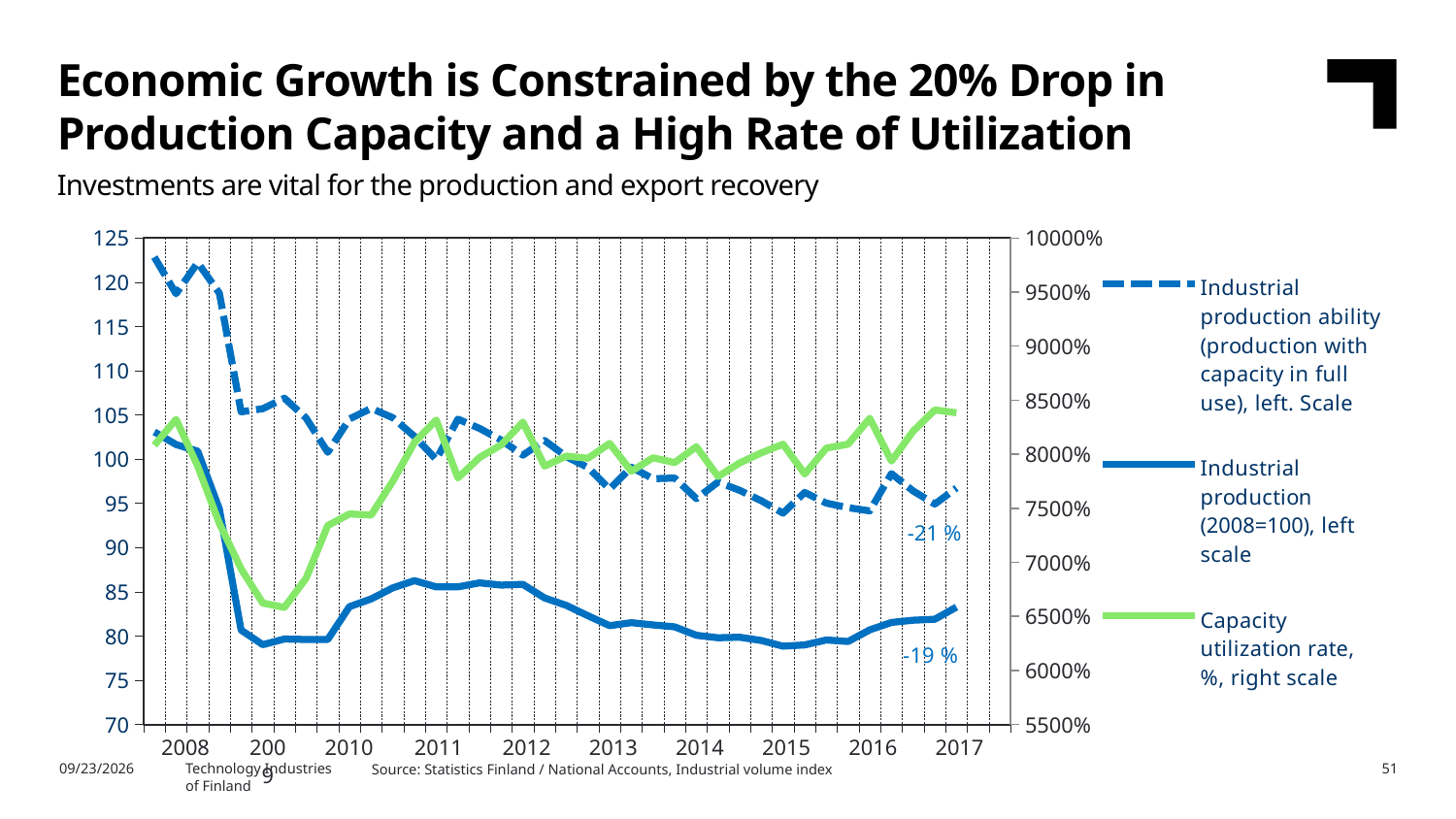
What percentage change is annotated next to the solid blue Industrial production line? -19 % What percentage change is annotated next to the dashed Industrial production ability line? -21 % How many series does the legend list? 3 Does the Industrial production ability series rise or fall overall from 2008 to 2017? fall Does the Capacity utilization rate rise or fall from its 2009 low to 2017? rise Is the value of Industrial production (2008=100) in 2017 greater or less than 90? less Which series is drawn with a dashed line? Industrial production ability Which series is plotted against the right scale? Capacity utilization rate In 2017, which is higher on the left scale: Industrial production ability or Industrial production (2008=100)? Industrial production ability Is the Capacity utilization rate in 2017 greater or less than 8000% on the right scale? greater Is the value of Industrial production ability at the start of 2008 greater or less than 115? greater What kind of chart is shown on the slide? line chart